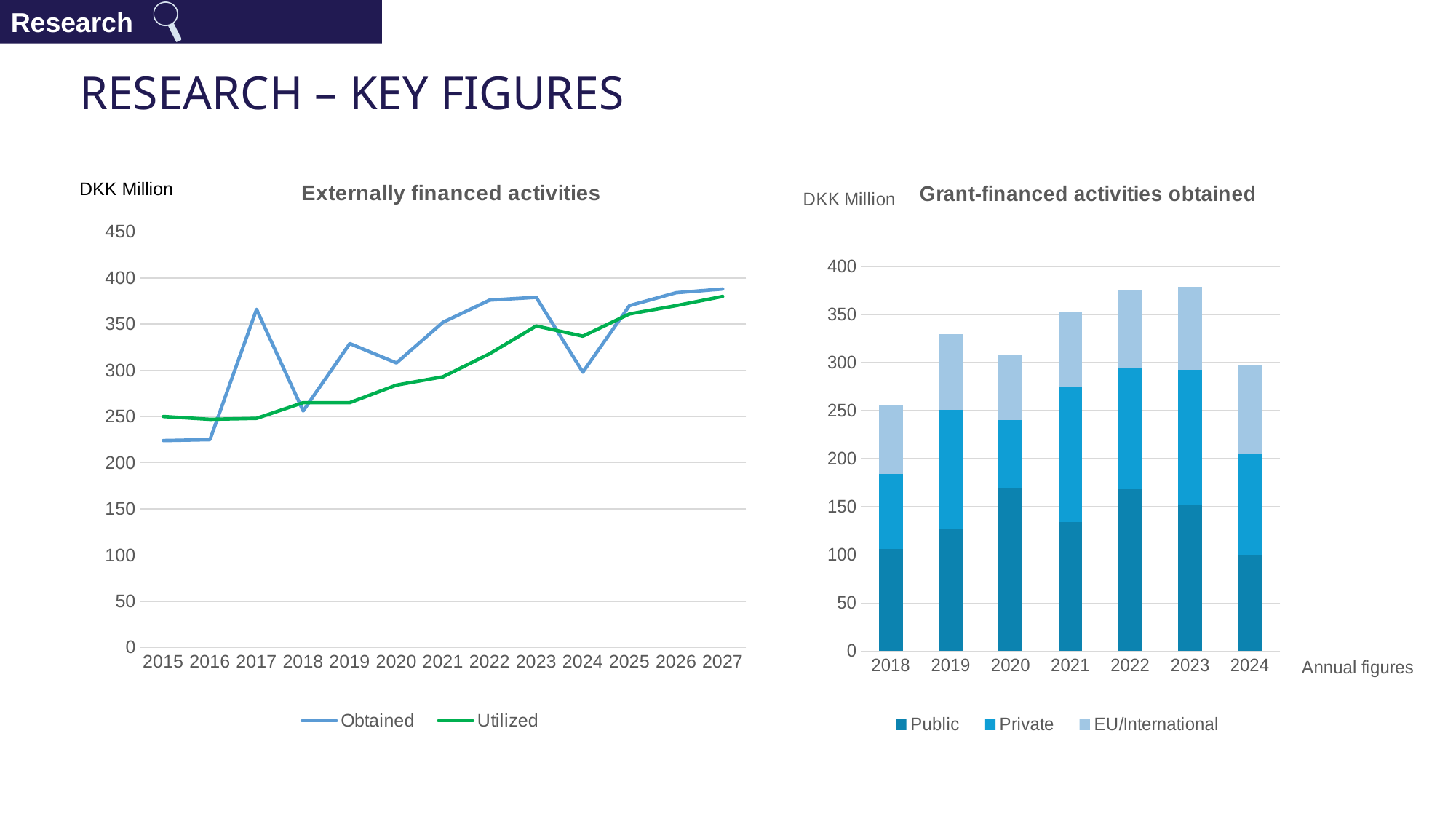
In the 'Externally financed activities' chart, is the Utilized value for 2015 greater or less than 300? less In the 'Externally financed activities' chart, how many years are shown on the x axis? 13 In the 'Grant-financed activities obtained' chart, which year has the lowest total bar? 2018 In the 'Grant-financed activities obtained' chart, is the total height of the 2018 bar greater or less than 300? less In the 'Grant-financed activities obtained' chart, how many series does the legend list? 3 In the 'Externally financed activities' chart, which series has the larger value in 2024, Obtained or Utilized? Utilized In the 'Externally financed activities' chart, how many series does the legend list? 2 In the 'Externally financed activities' chart, does the Utilized line generally rise or fall from 2015 to 2027? Rise What kind of chart is the 'Grant-financed activities obtained' chart on the right? Bar chart In the 'Grant-financed activities obtained' chart, how many years are shown on the x axis? 7 In the 'Externally financed activities' chart, is the Obtained value for 2017 greater or less than 350? greater What kind of chart is the 'Externally financed activities' chart on the left? Line chart